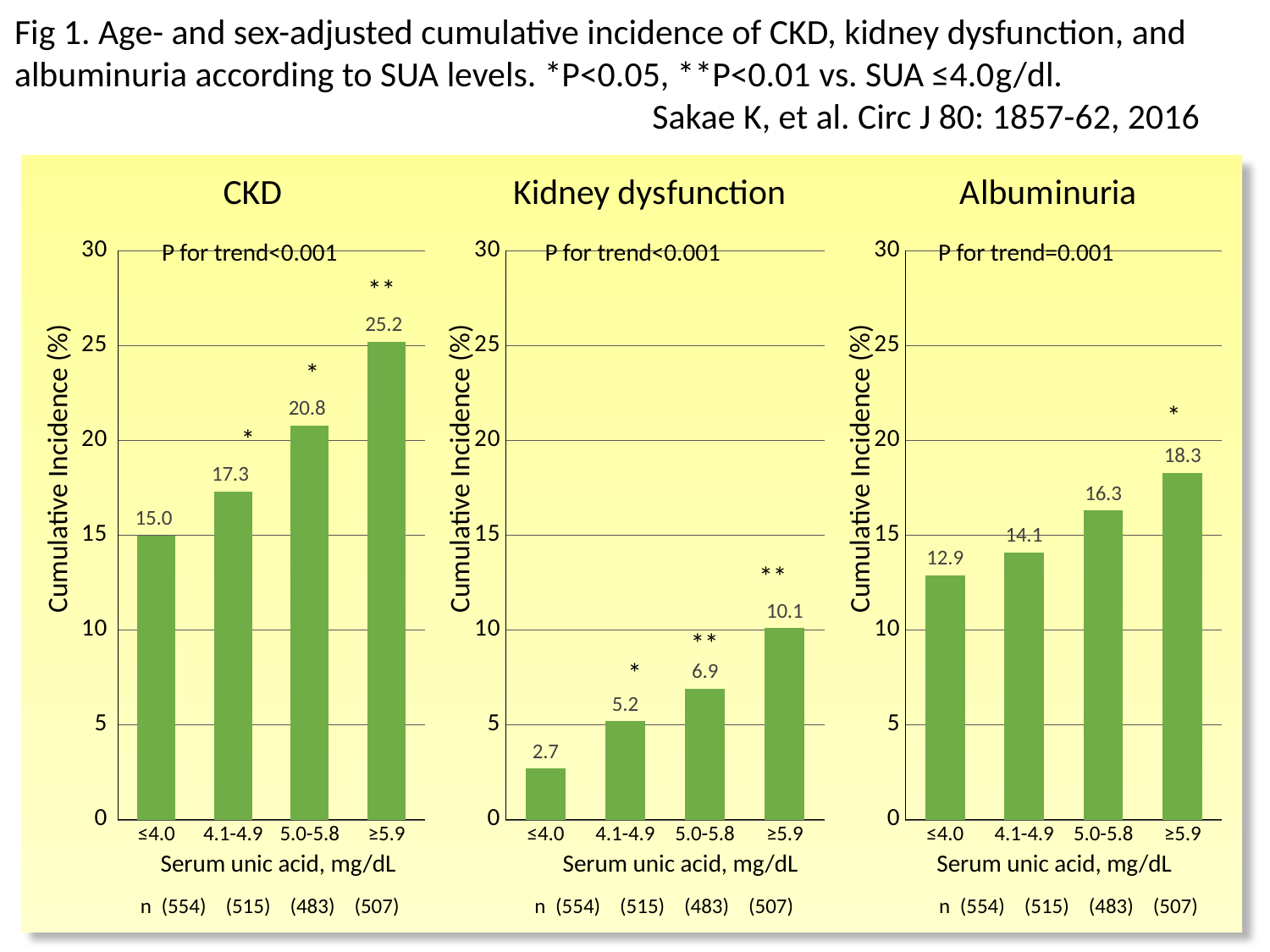
How many serum uric acid groups are shown in the Kidney dysfunction chart? 4 In the CKD chart, what is the cumulative incidence for the ≥5.9 serum uric acid group? 25.2 In the CKD chart, do the cumulative incidence values rise or fall as serum uric acid increases along the x axis? Rise In the CKD chart, which serum uric acid group has the lowest cumulative incidence? ≤4.0 In the Albuminuria chart, what is the cumulative incidence for the 5.0-5.8 serum uric acid group? 16.3 In the Kidney dysfunction chart, which serum uric acid group has the highest cumulative incidence? ≥5.9 In the Albuminuria chart, what is the difference in cumulative incidence between the ≥5.9 group and the ≤4.0 group? 5.4 What type of chart is the Albuminuria chart? Bar chart In the CKD chart, what is the difference in cumulative incidence between the 5.0-5.8 group and the 4.1-4.9 group? 3.5 What is the y-axis label on the Kidney dysfunction chart? Cumulative Incidence (%) In the Kidney dysfunction chart, what is the cumulative incidence for the ≤4.0 serum uric acid group? 2.7 Which is larger: the cumulative incidence for the ≥5.9 group in the Kidney dysfunction chart or the ≤4.0 group in the Albuminuria chart? ≤4.0 group in the Albuminuria chart